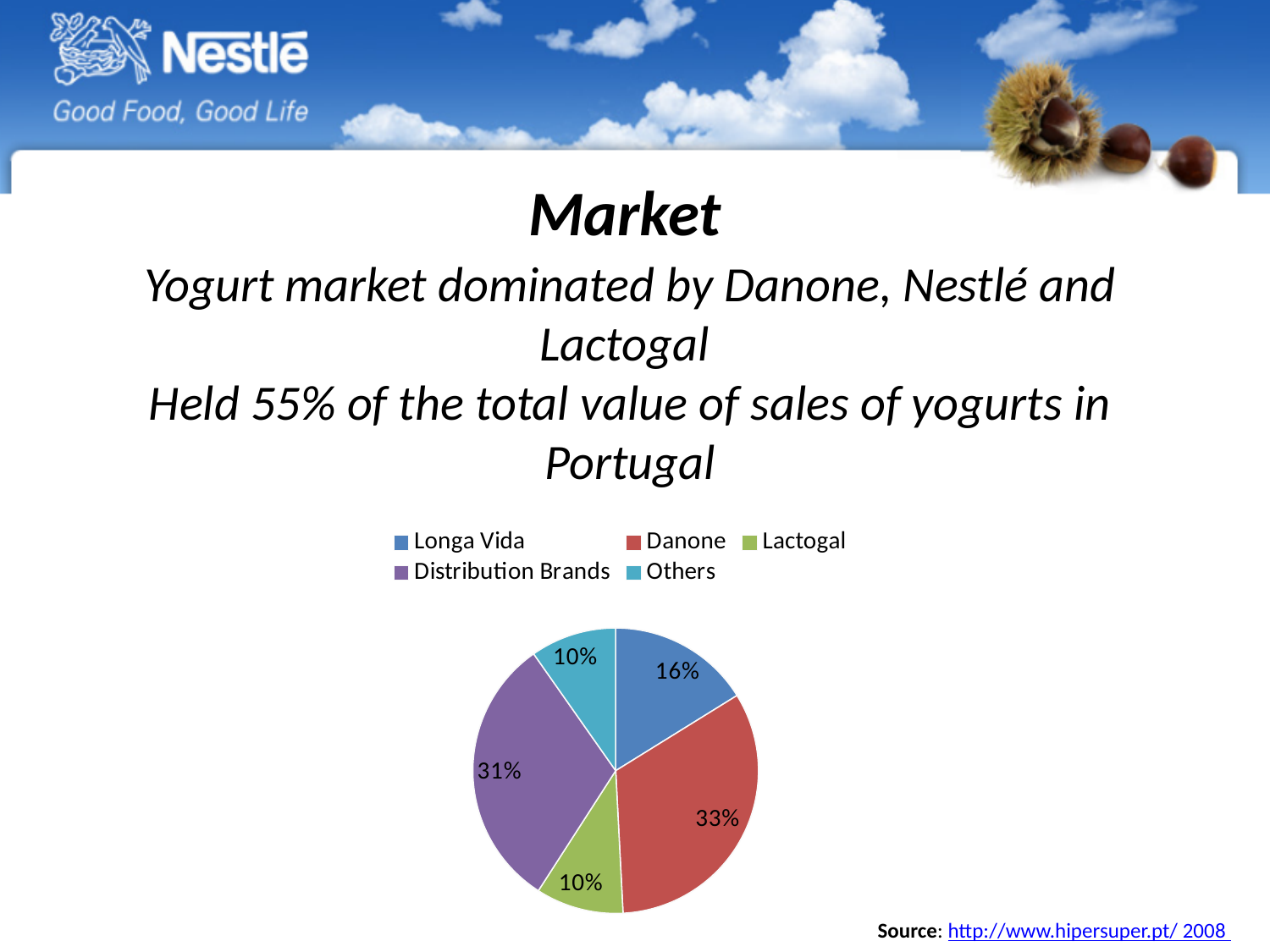
What share of the pie does Others hold? 10% Which is larger, the Distribution Brands slice or the Longa Vida slice? Distribution Brands What colour is the Danone slice in the pie chart? Red What share of the pie does Longa Vida hold? 16% What share of the pie does Danone hold? 33% What type of chart is shown on the slide? Pie chart Which category has the largest slice of the pie? Danone How many slices does the pie chart have? 5 What share of the pie does Distribution Brands hold? 31% What share of the pie does Lactogal hold? 10% How many entries does the legend list? 5 What is the difference between the Danone share and the Longa Vida share? 17%